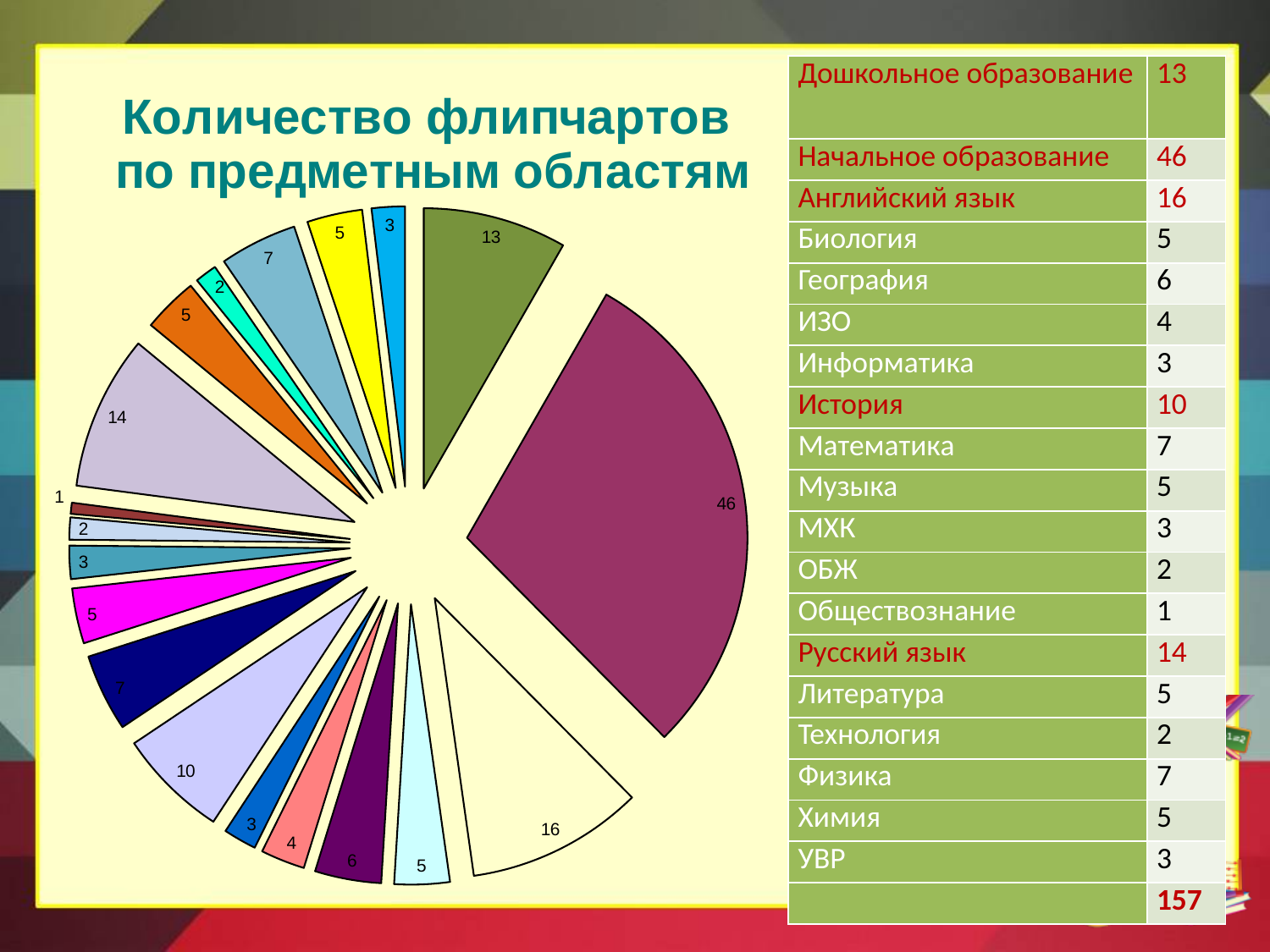
Which has more flipcharts, История or Математика? История What kind of chart is shown on the slide? Pie chart What is the title of the chart? Количество флипчартов по предметным областям How many flipcharts are there for Русский язык? 14 Which subject area has the largest number of flipcharts? Начальное образование What is the difference between the number of flipcharts for Начальное образование and Дошкольное образование? 33 Which subject area has the smallest number of flipcharts? Обществознание How many slices does the pie chart have? 19 What is the total number of flipcharts across all subject areas? 157 How many flipcharts are there for Английский язык? 16 What is the difference between the number of flipcharts for Английский язык and Русский язык? 2 What is the value of the largest slice in the pie chart? 46